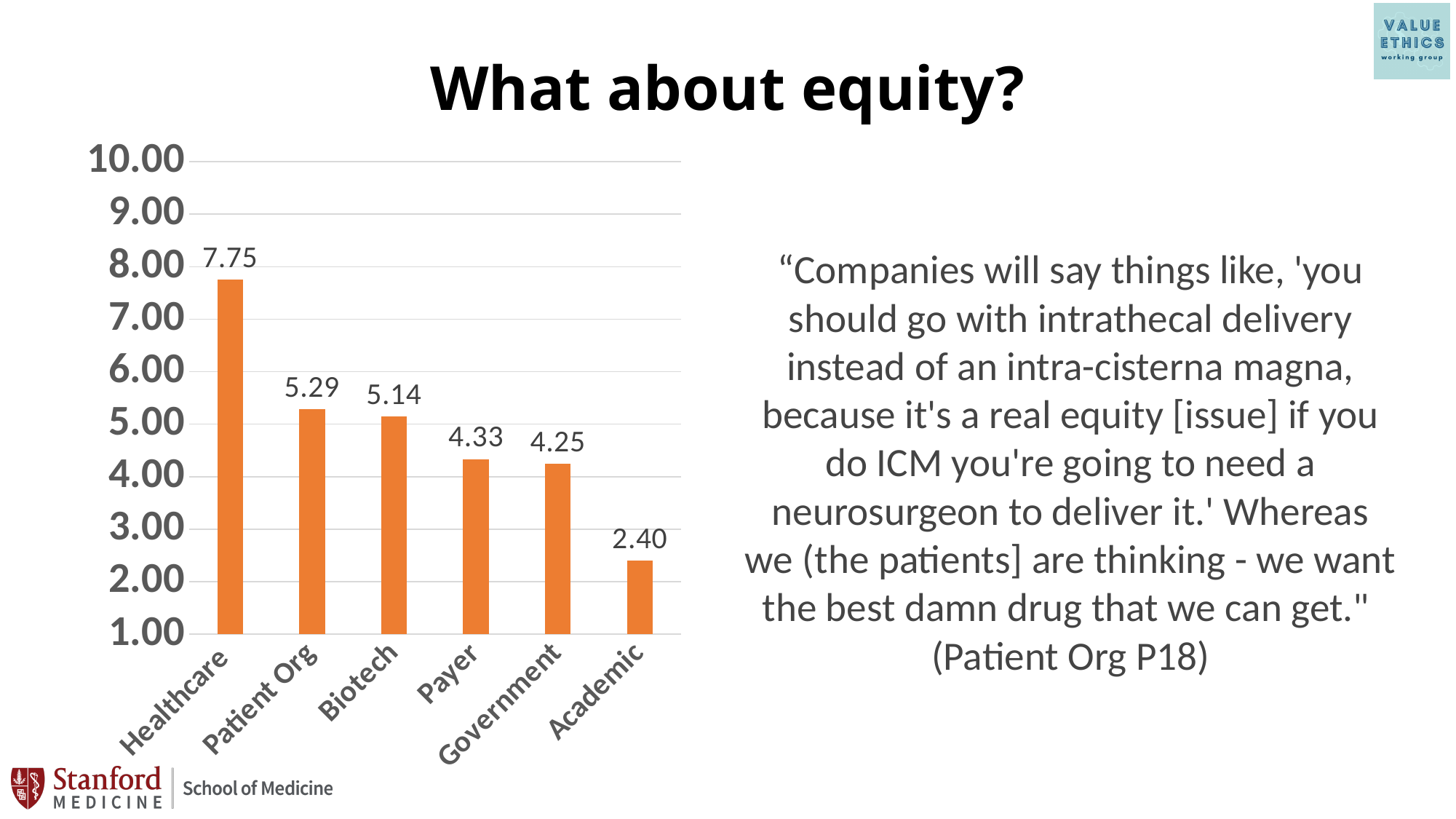
Is the value for Government greater or less than 5.00? less What is the value for Healthcare? 7.75 How many categories are shown on the x axis? 6 What is the value for Patient Org? 5.29 What is the value for Academic? 2.40 What is the difference between the values for Healthcare and Academic? 5.35 What kind of chart is shown on the slide? bar chart Which category has the lowest value? Academic What is the difference between the values for Patient Org and Biotech? 0.15 What colour are the bars in the chart? orange Which is larger, the value for Biotech or the value for Payer? Biotech Which category has the highest value? Healthcare